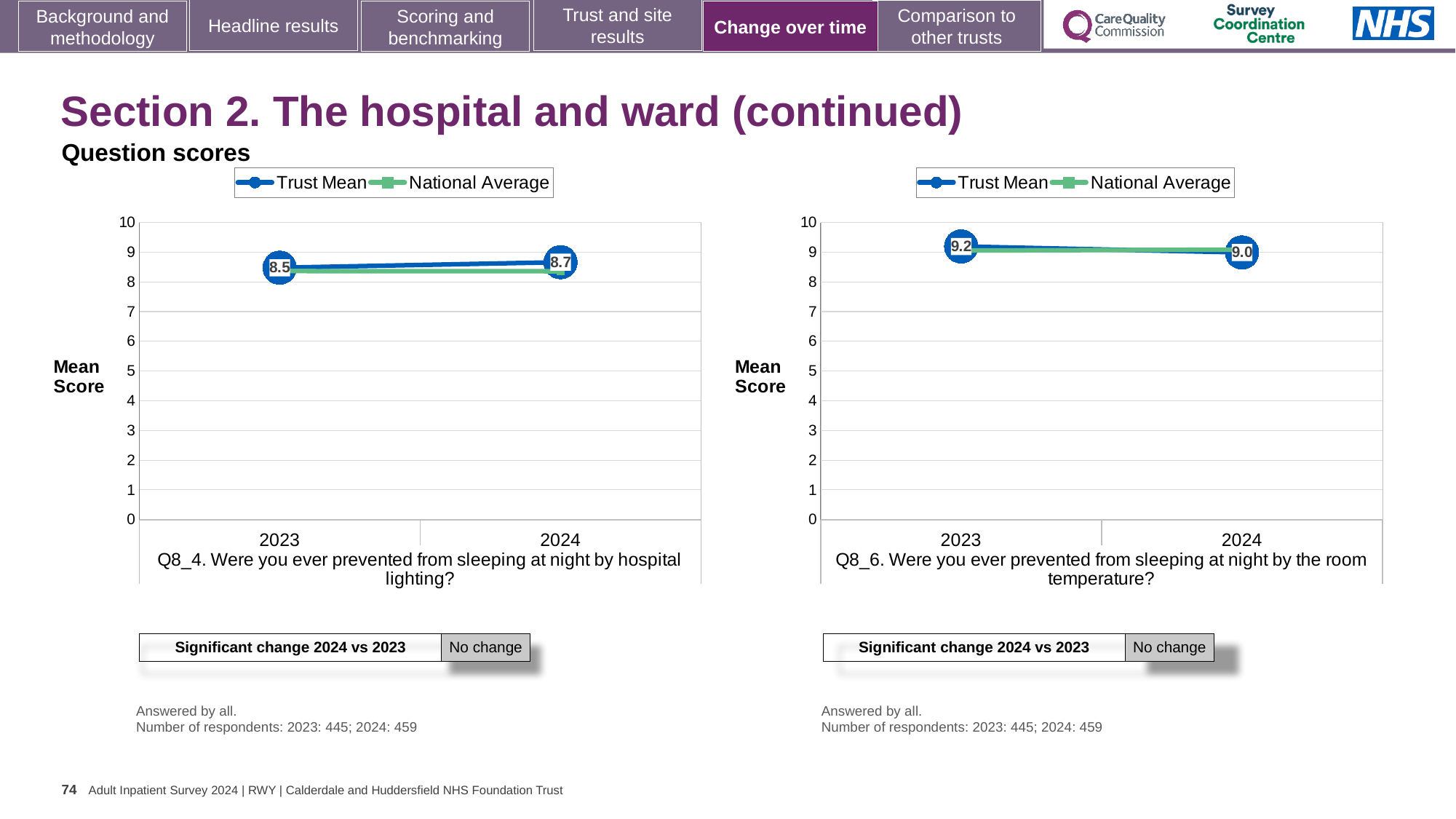
On the left chart (Q8_4, hospital lighting), what is the Trust Mean for 2023? 8.5 On the right chart (Q8_6), which year has the higher Trust Mean, 2023 or 2024? 2023 On the left chart (Q8_4), by how much did the Trust Mean change from 2023 to 2024? 0.2 How many series does the legend of the left chart list? 2 On the left chart (Q8_4), does the Trust Mean rise or fall from 2023 to 2024? rise On the left chart (Q8_4), is the National Average for 2023 greater or less than 8? greater On the right chart (Q8_6, room temperature), what is the Trust Mean for 2024? 9.0 On the right chart (Q8_6), does the Trust Mean rise or fall from 2023 to 2024? fall On the left chart (Q8_4, hospital lighting), what is the Trust Mean for 2024? 8.7 On the right chart (Q8_6), what is the difference between the Trust Mean in 2023 and 2024? 0.2 On the right chart (Q8_6, room temperature), what is the Trust Mean for 2023? 9.2 What kind of chart is the right chart (Q8_6)? line chart